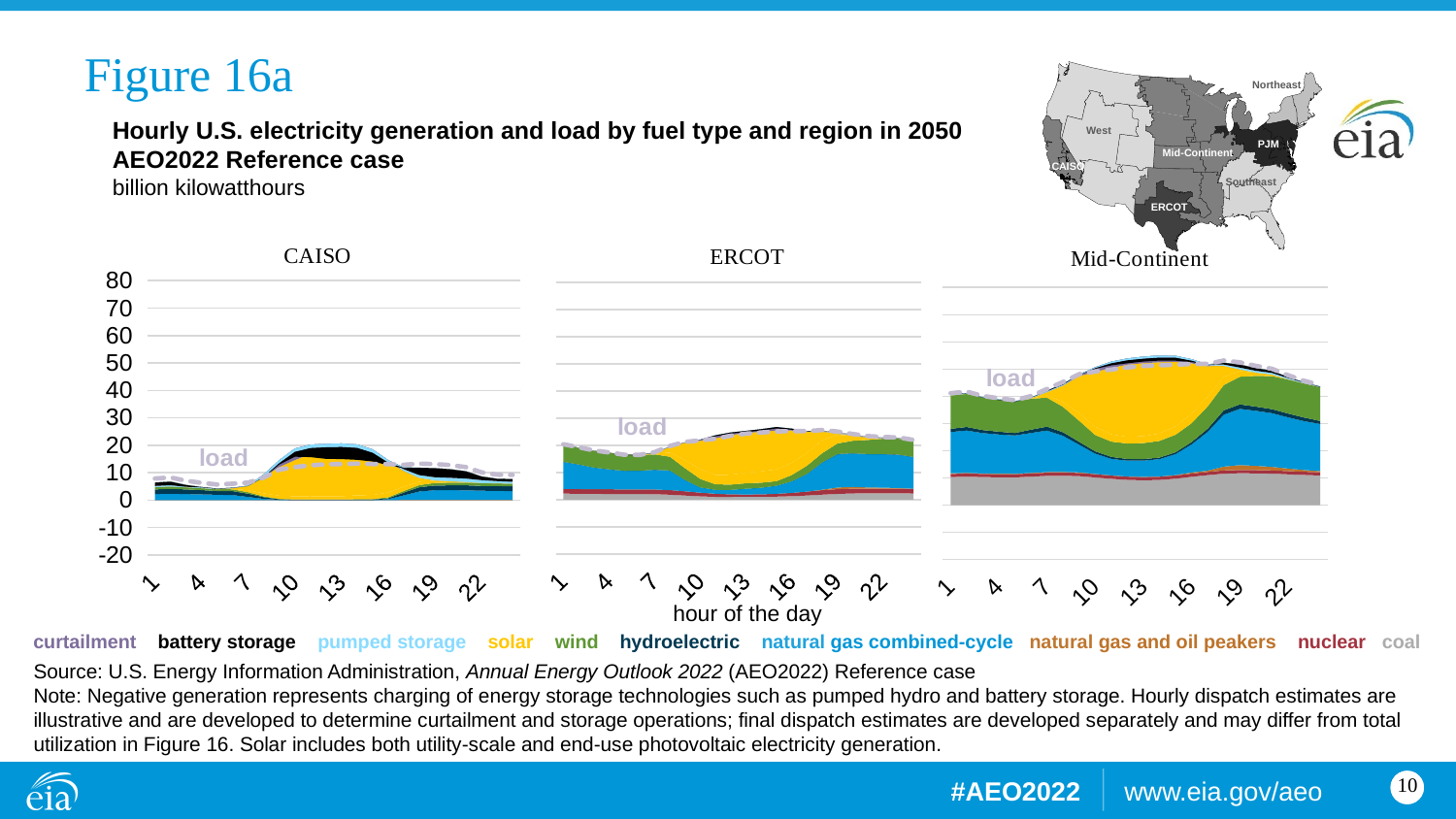
In the ERCOT chart, is the total generation at hour 13 greater or less than 40? less In the ERCOT chart, is the total generation at hour 1 greater or less than 30? less How many regional charts are shown on the slide? 3 How many fuel types or technologies does the legend list? 10 What kind of chart is used for the CAISO, ERCOT and Mid-Continent panels? stacked area chart Which region's chart reaches the highest total generation? Mid-Continent In the Mid-Continent chart, is the total generation at hour 13 greater or less than 40? greater What unit is used on the y axis of the charts? billion kilowatthours In the CAISO chart, does total generation rise or fall between hour 7 and hour 12? rise What is the label of the x axis shared by the three charts? hour of the day Which region's chart has the lowest peak total generation? CAISO